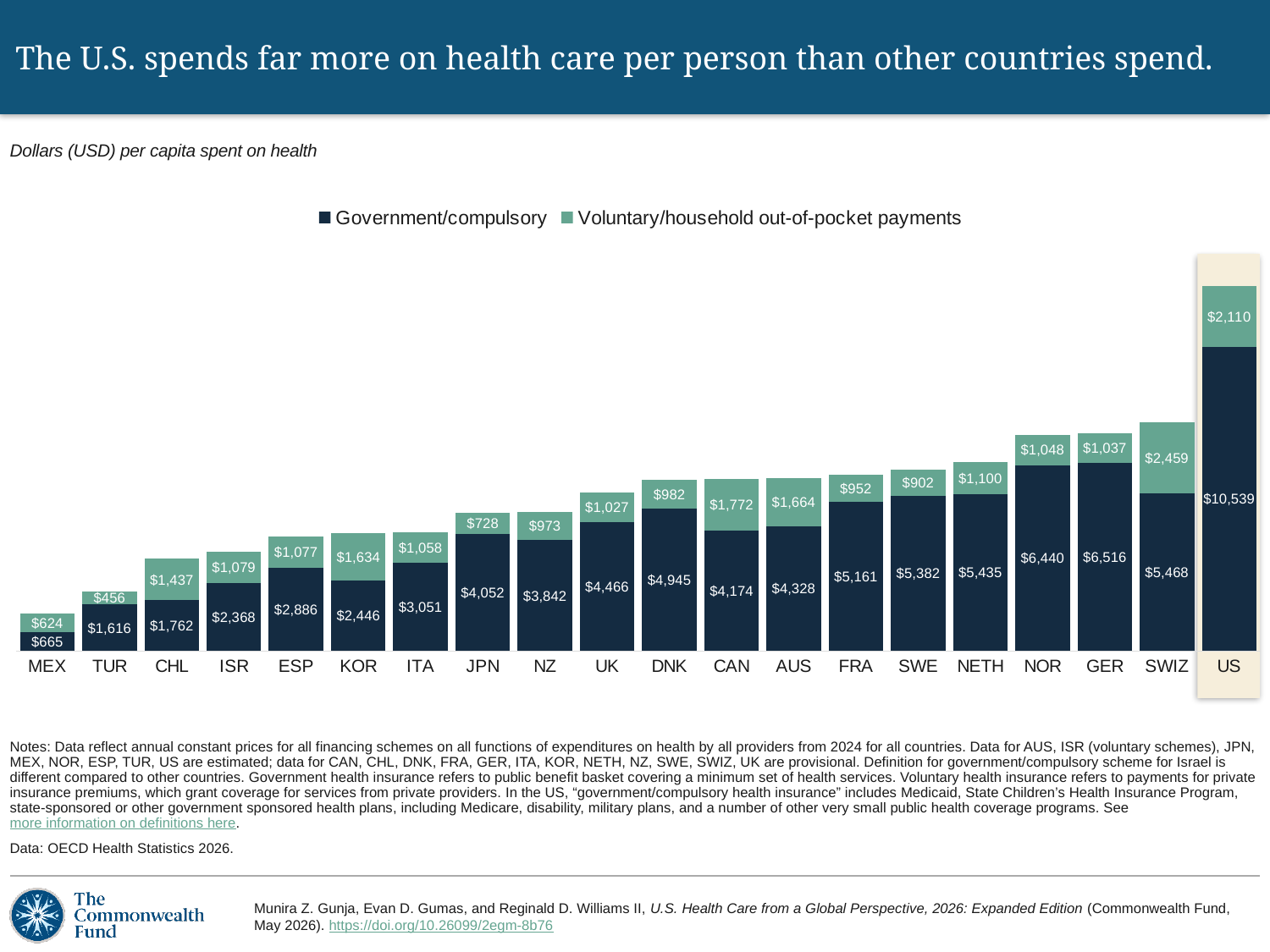
What is the total of the stacked bar for the US? $12,649 Which country has the highest Government/compulsory value? US How many countries are shown on the chart? 20 What is the Voluntary/household out-of-pocket payments value for SWIZ? $2,459 What is the total of the stacked bar for MEX? $1,289 What is the Government/compulsory value for JPN? $4,052 What kind of chart is shown on the slide? Stacked bar chart Which is larger, the Voluntary/household out-of-pocket payments value for CAN or for AUS? CAN What is the Government/compulsory value for the US? $10,539 Which country has the lowest Voluntary/household out-of-pocket payments value? TUR How many series does the legend list? 2 What is the difference between the Government/compulsory values for the US and GER? $4,023